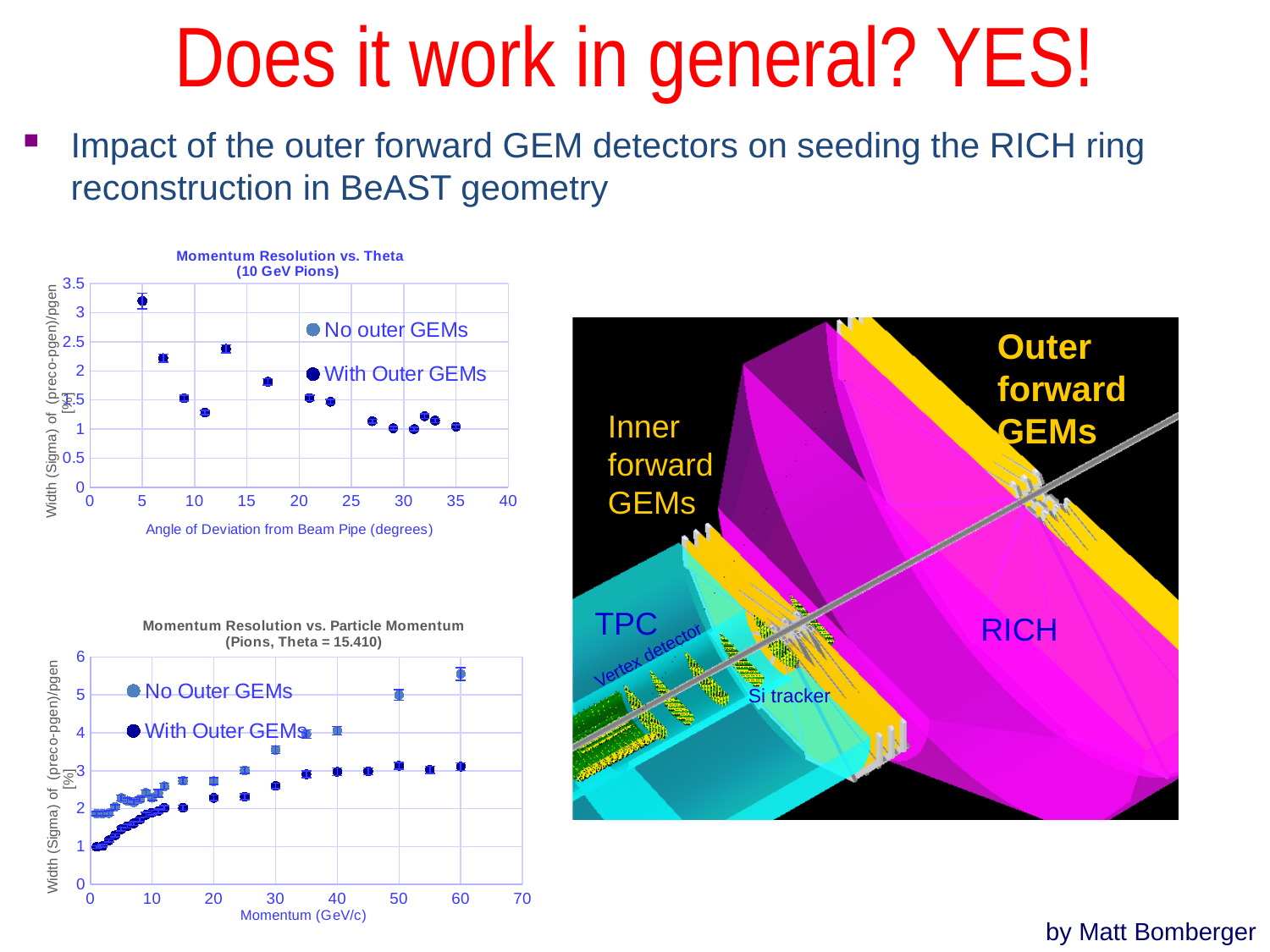
How many series does the legend of the 'Momentum Resolution vs. Particle Momentum' chart list? 2 What is the x-axis label of the 'Momentum Resolution vs. Particle Momentum' chart? Momentum (GeV/c) In the 'Momentum Resolution vs. Particle Momentum' chart, do the 'With Outer GEMs' values rise or fall as momentum increases? rise How many series does the legend of the 'Momentum Resolution vs. Theta' chart list? 2 In the 'Momentum Resolution vs. Theta' chart, is the value at 5 degrees greater or less than 3? greater What kind of chart is the 'Momentum Resolution vs. Particle Momentum' chart? Scatter chart In the 'Momentum Resolution vs. Theta' chart, is the value at 17 degrees greater or less than 2? less In the 'Momentum Resolution vs. Particle Momentum' chart, which series has the higher value at 60 GeV/c, 'No Outer GEMs' or 'With Outer GEMs'? No Outer GEMs In the 'Momentum Resolution vs. Theta' chart, do the values generally rise or fall as the angle increases? fall In the 'Momentum Resolution vs. Particle Momentum' chart, is the 'No Outer GEMs' value at 60 GeV/c greater or less than 5? greater What kind of chart is the 'Momentum Resolution vs. Theta (10 GeV Pions)' chart? Scatter chart What is the x-axis label of the 'Momentum Resolution vs. Theta' chart? Angle of Deviation from Beam Pipe (degrees)